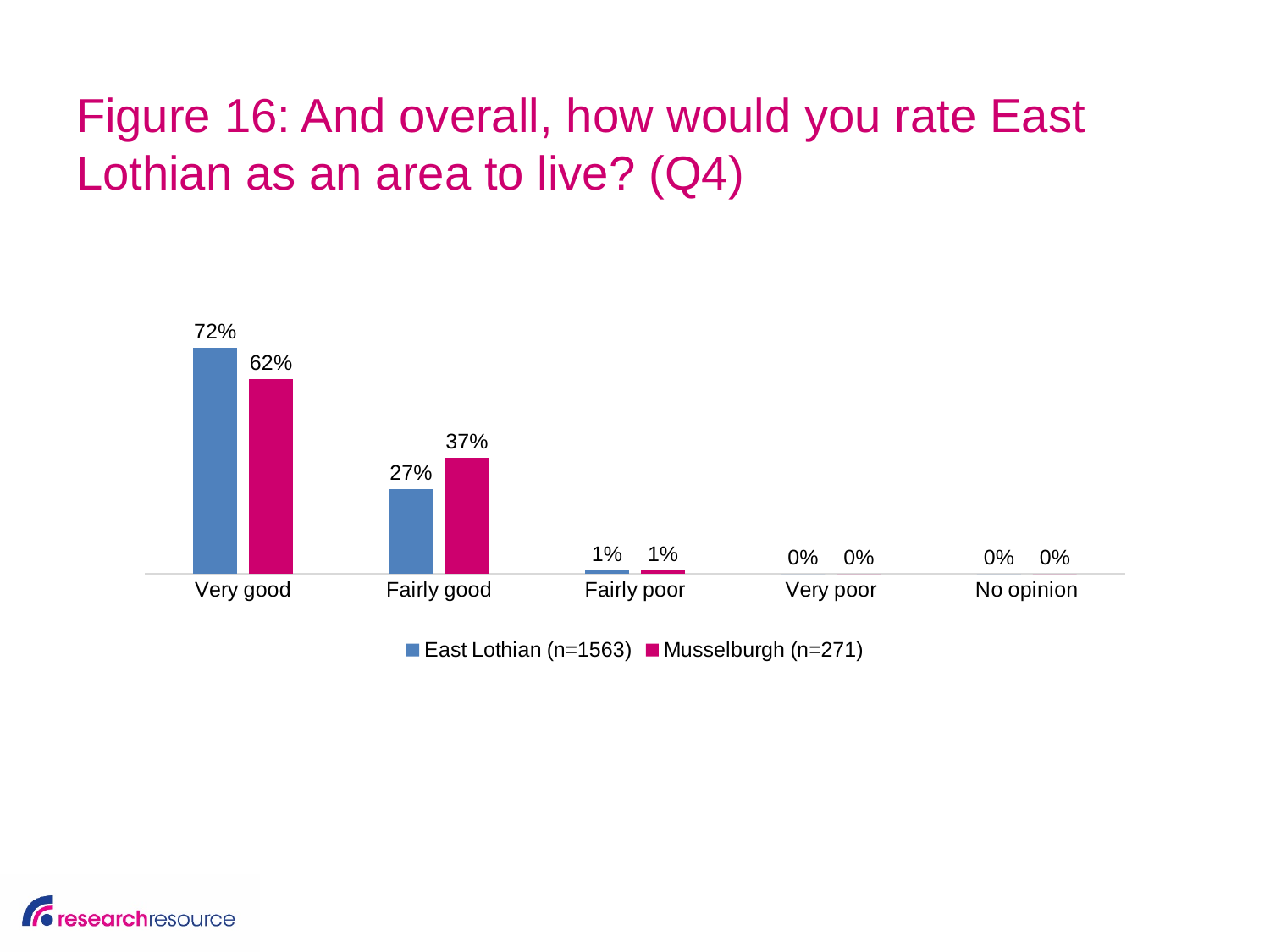
How many series does the legend list? 2 What is the difference between the Musselburgh and East Lothian values for 'Fairly good'? 10% How many response categories are shown on the x axis? 5 What percentage of East Lothian respondents rated the area as 'Very good'? 72% Which is larger for 'Fairly good': East Lothian or Musselburgh? Musselburgh What is the sample size (n) for Musselburgh shown in the legend? 271 Which is larger for 'Very good': East Lothian or Musselburgh? East Lothian What is the difference between the East Lothian and Musselburgh values for 'Very good'? 10% Which category has the highest value for East Lothian? Very good What is the Musselburgh value for 'Very good'? 62% What kind of chart is shown on the slide? Bar chart What percentage of Musselburgh respondents rated the area as 'Fairly good'? 37%